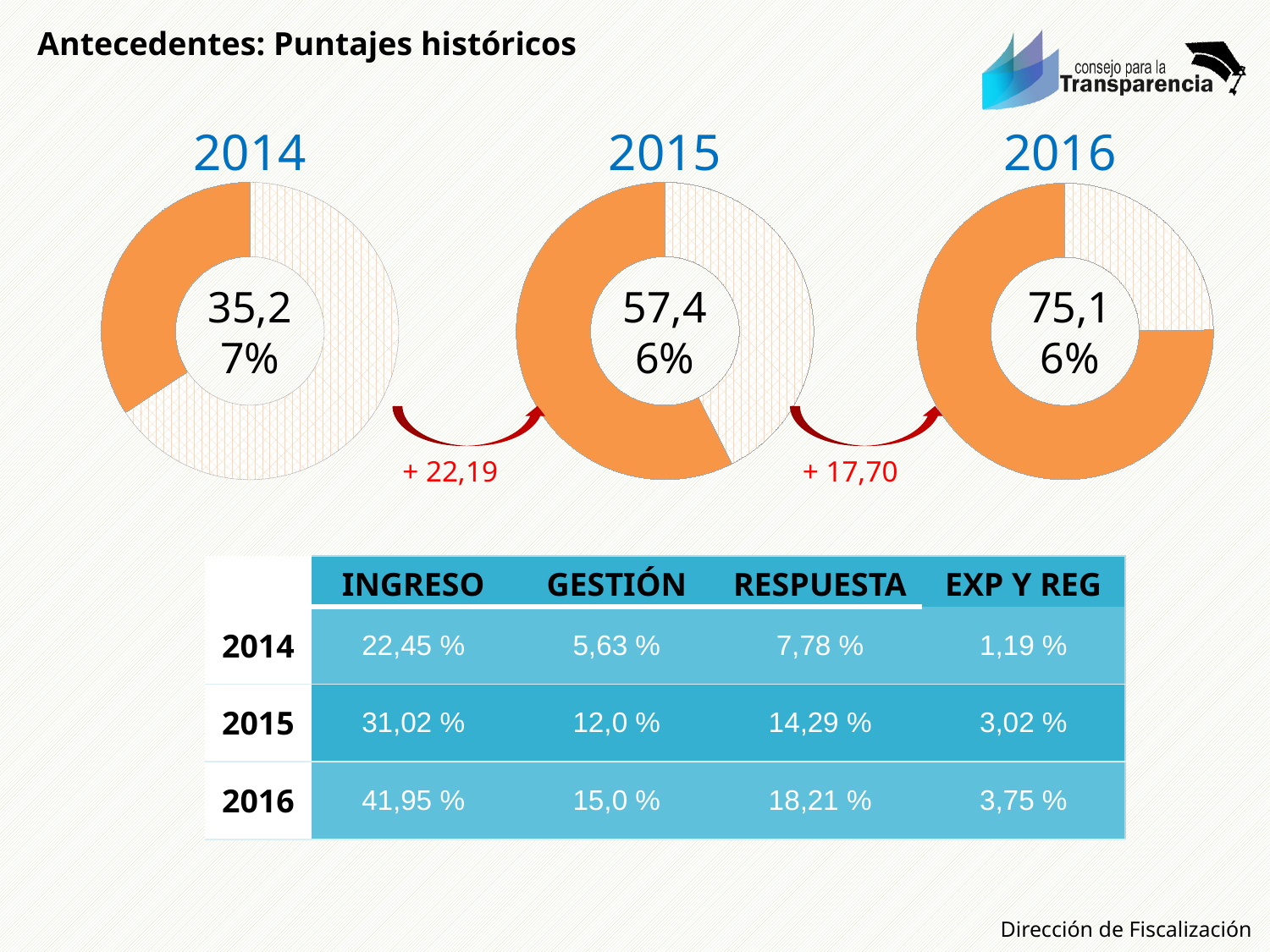
Which year's donut chart shows the lowest percentage? 2014 By how much did the percentage increase from the 2014 donut chart to the 2015 donut chart? 22,19 How many donut charts are shown on the slide? 3 What value is shown in the centre of the 2016 donut chart? 75,16% What is the difference between the percentage in the 2016 donut chart and the 2014 donut chart? 39,89 Which year's donut chart shows the highest percentage? 2016 What value is shown in the centre of the 2015 donut chart? 57,46% What kind of charts are shown at the top of the slide? Donut (pie) charts By how much did the percentage increase from the 2015 donut chart to the 2016 donut chart? 17,70 Do the percentages in the donut charts rise or fall from 2014 to 2016? Rise Which is larger, the percentage in the 2015 donut chart or the 2016 donut chart? 2016 What value is shown in the centre of the 2014 donut chart? 35,27%